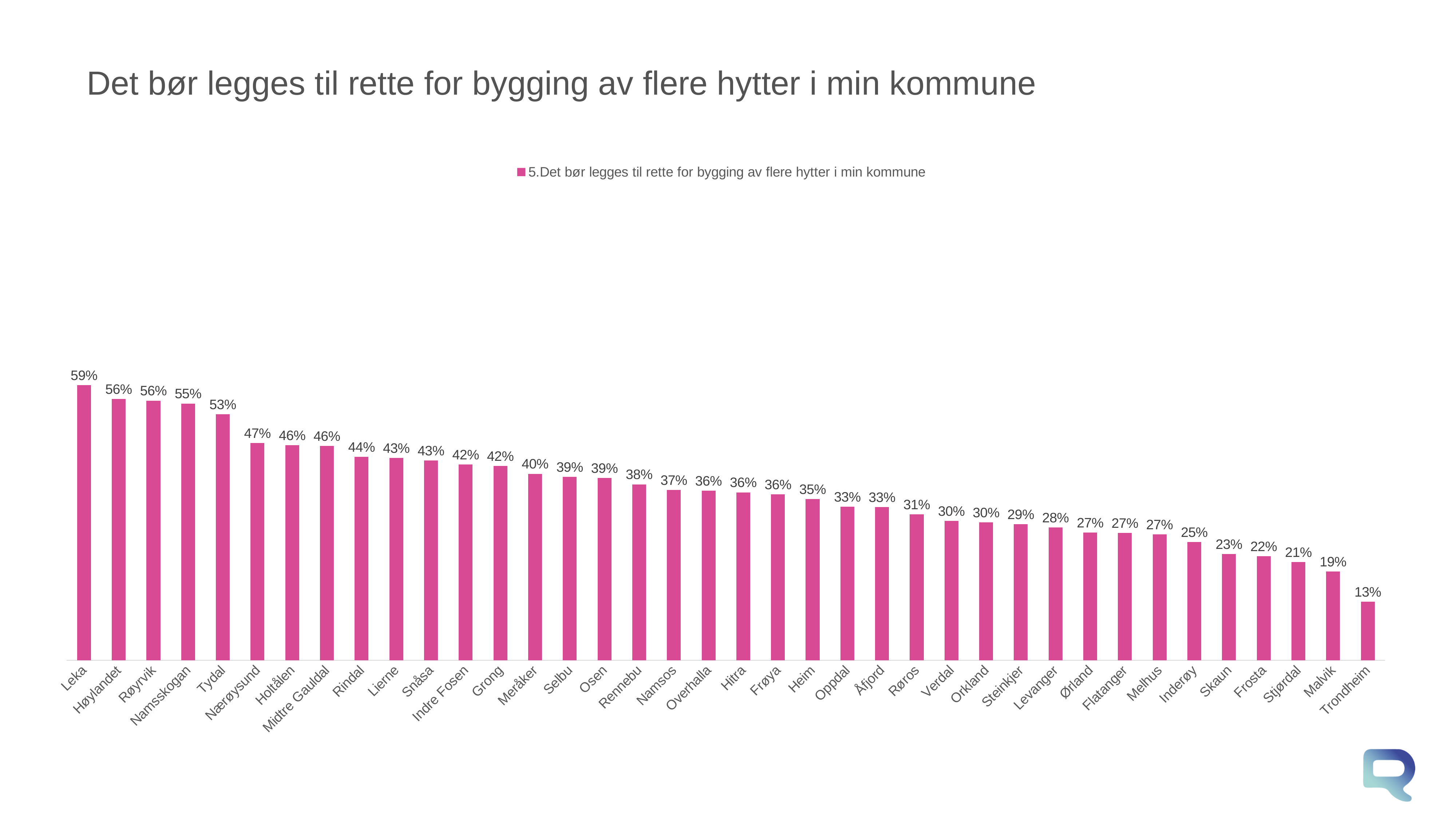
What is the difference between the values for Leka and Trondheim? 46% Which municipality has the highest value? Leka What is the difference between the values for Tydal and Nærøysund? 6% How many municipalities are shown on the x axis? 38 What kind of chart is shown on the slide? Bar chart Which has a larger value, Rindal or Meråker? Rindal Do the values rise or fall from left to right along the x axis? Fall Which municipality has the lowest value? Trondheim What is the value for Trondheim? 13% What is the value for Leka? 59% What is the value for Midtre Gauldal? 46% What is the value for Steinkjer? 29%